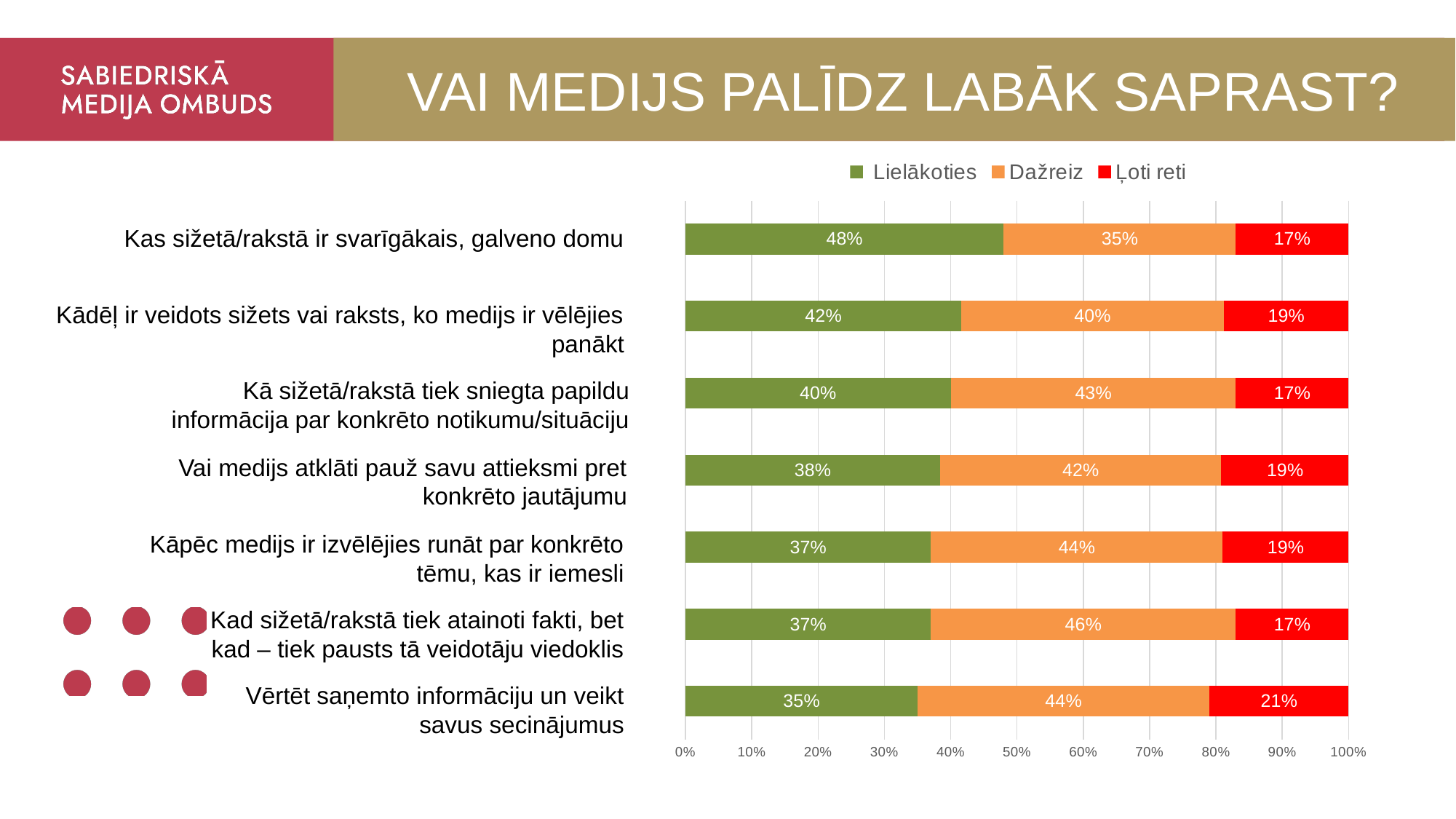
How many categories (statements) are plotted in the chart? 7 Which category has the lowest 'Lielākoties' value? Vērtēt saņemto informāciju un veikt savus secinājumus What kind of chart is shown on the slide? Stacked bar chart Which is larger: the 'Dažreiz' value for 'Kā sižetā/rakstā tiek sniegta papildu informācija par konkrēto notikumu/situāciju' or for 'Kāpēc medijs ir izvēlējies runāt par konkrēto tēmu, kas ir iemesli'? Kāpēc medijs ir izvēlējies runāt par konkrēto tēmu, kas ir iemesli What is the 'Lielākoties' value for 'Kas sižetā/rakstā ir svarīgākais, galveno domu'? 48% Which colour represents the 'Ļoti reti' series in the chart? Red What is the difference between the 'Lielākoties' values for 'Kas sižetā/rakstā ir svarīgākais, galveno domu' and 'Kādēļ ir veidots sižets vai raksts, ko medijs ir vēlējies panākt'? 6% Which category has the highest 'Lielākoties' value? Kas sižetā/rakstā ir svarīgākais, galveno domu What is the 'Dažreiz' value for 'Kad sižetā/rakstā tiek atainoti fakti, bet kad – tiek pausts tā veidotāju viedoklis'? 46% What is the 'Ļoti reti' value for 'Vērtēt saņemto informāciju un veikt savus secinājumus'? 21% How many series does the legend list? 3 What is the total of the stacked bar for 'Kas sižetā/rakstā ir svarīgākais, galveno domu'? 100%